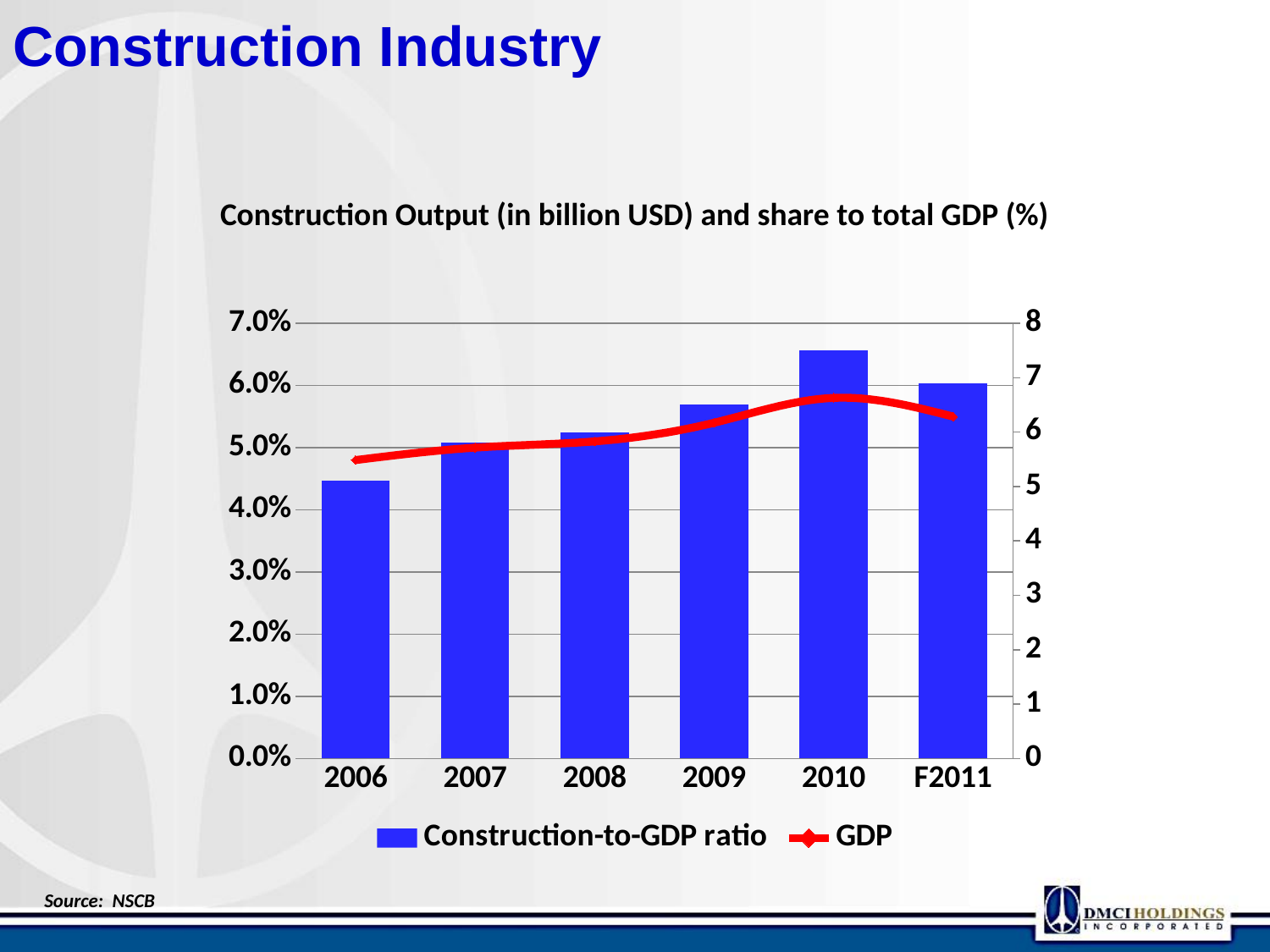
Which year has the lowest Construction-to-GDP ratio bar? 2006 In which year does the GDP line reach its peak? 2010 Is the Construction-to-GDP ratio for 2009 greater or less than 5.0%? greater Which year has the highest Construction-to-GDP ratio bar? 2010 Is the Construction-to-GDP ratio for 2010 greater or less than 6.0%? greater Is the GDP line value for 2006 greater or less than 6 on the right axis? less How many series does the legend list? 2 Which is larger, the Construction-to-GDP ratio for 2009 or for 2007? 2009 How many years are shown on the x axis? 6 What type of chart is shown on the slide? Combined bar and line chart What is the title of the chart? Construction Output (in billion USD) and share to total GDP (%)